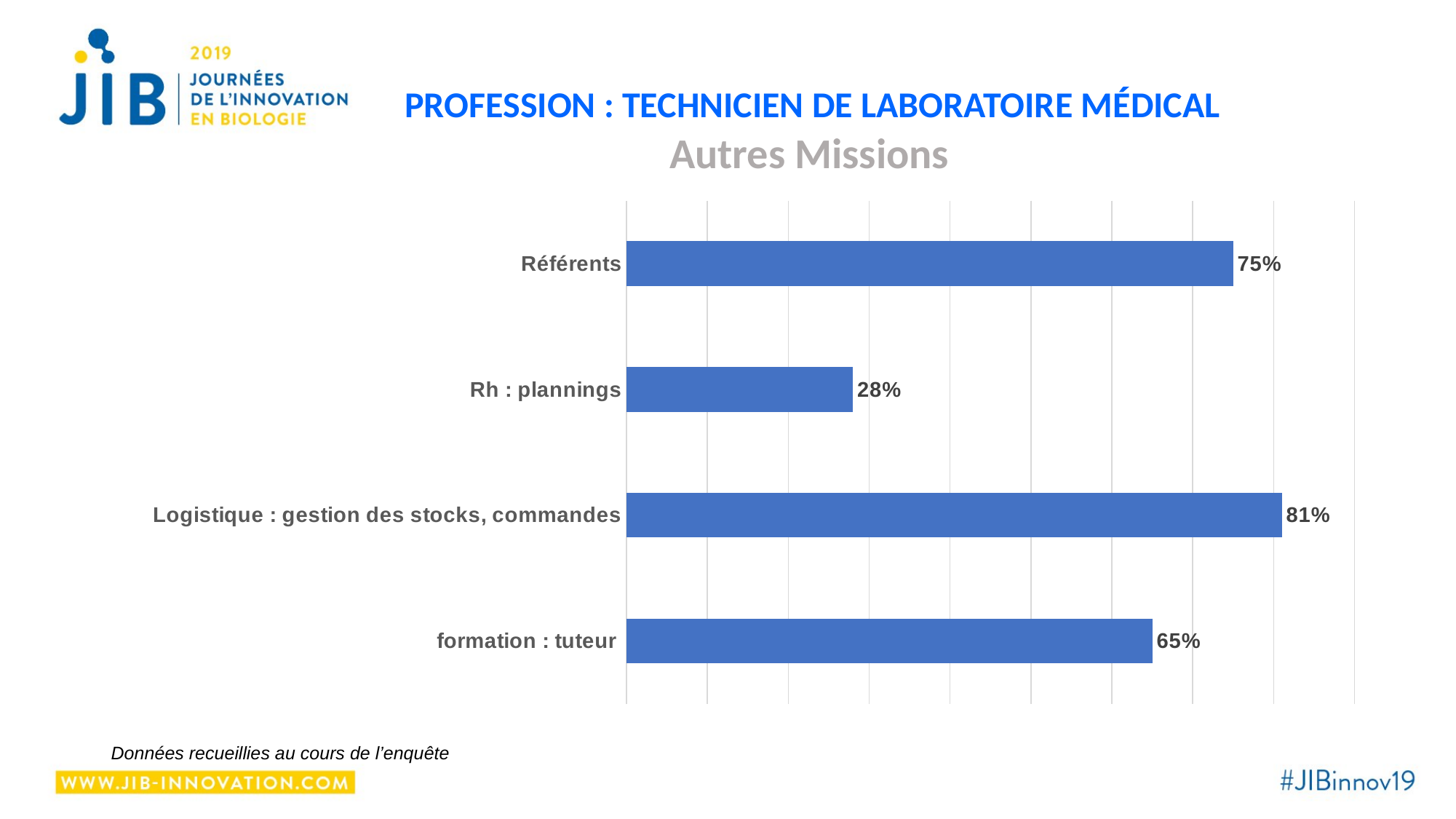
What is the difference between the values for Référents and Rh : plannings? 47% What is the title of the chart? Autres Missions Which category has the highest value? Logistique : gestion des stocks, commandes What is the value for Rh : plannings? 28% What kind of chart is shown on the slide? Bar chart Which is larger, the value for Référents or the value for formation : tuteur? Référents How many categories are shown in the chart? 4 What is the value for Logistique : gestion des stocks, commandes? 81% What is the value for formation : tuteur? 65% Which category has the lowest value? Rh : plannings What is the difference between the values for Logistique : gestion des stocks, commandes and Référents? 6% What is the value for Référents? 75%